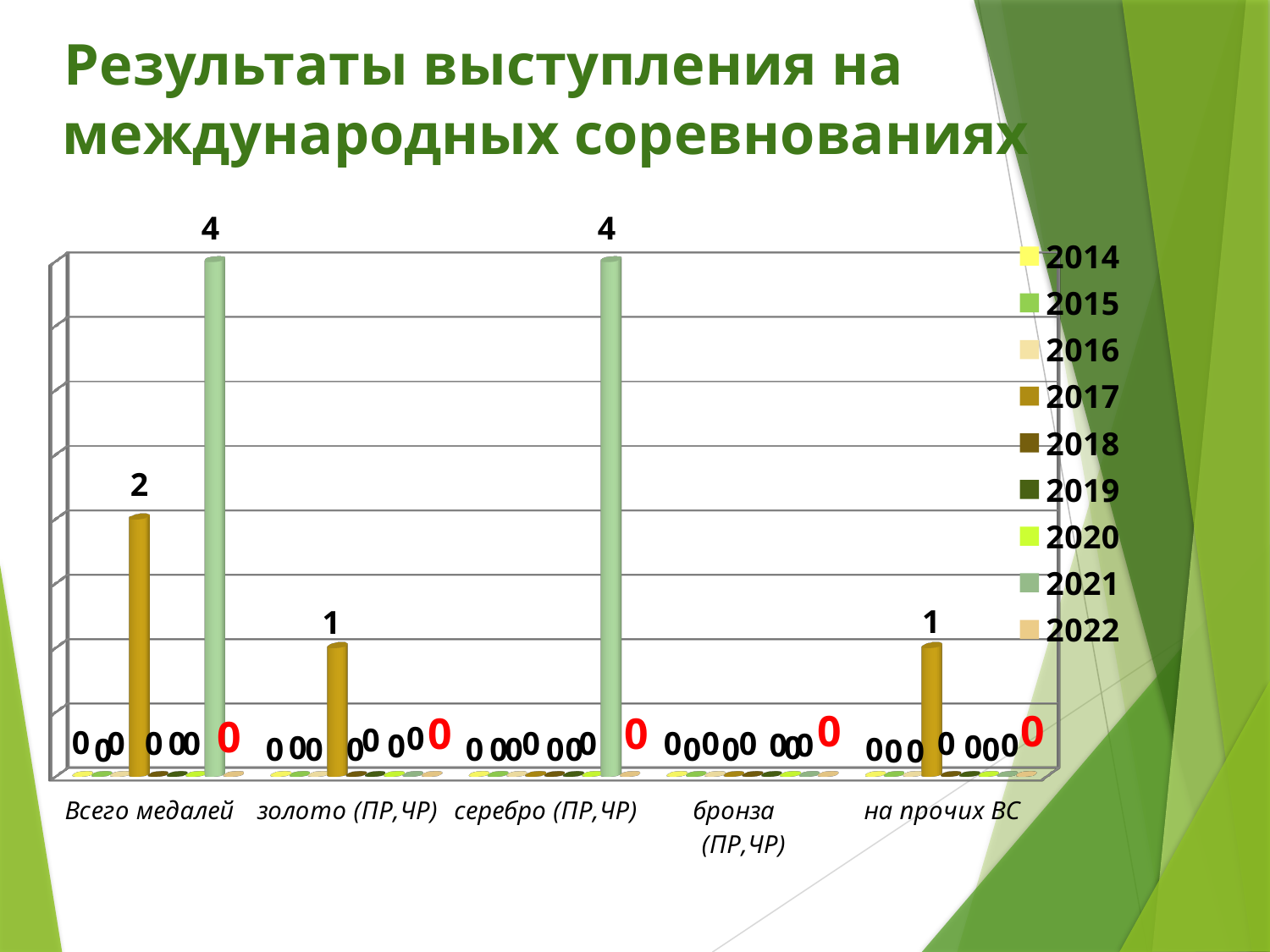
What is the value for 2021 in the category 'серебро (ПР,ЧР)'? 4 What is the value for 2017 in the category 'золото (ПР,ЧР)'? 1 How many categories are shown on the x axis? 5 What is the value for 2017 in the category 'Всего медалей'? 2 Which year has the highest value in the category 'Всего медалей'? 2021 What is the value for 2021 in the category 'Всего медалей'? 4 What kind of chart is shown on the slide? bar chart What is the value for 2017 in the category 'на прочих ВС'? 1 What is the title of the chart on the slide? Результаты выступления на международных соревнованиях How many series does the legend list? 9 Which is larger in the category 'Всего медалей': the value for 2021 or the value for 2017? 2021 What is the difference between the 2021 and 2017 values in the category 'Всего медалей'? 2